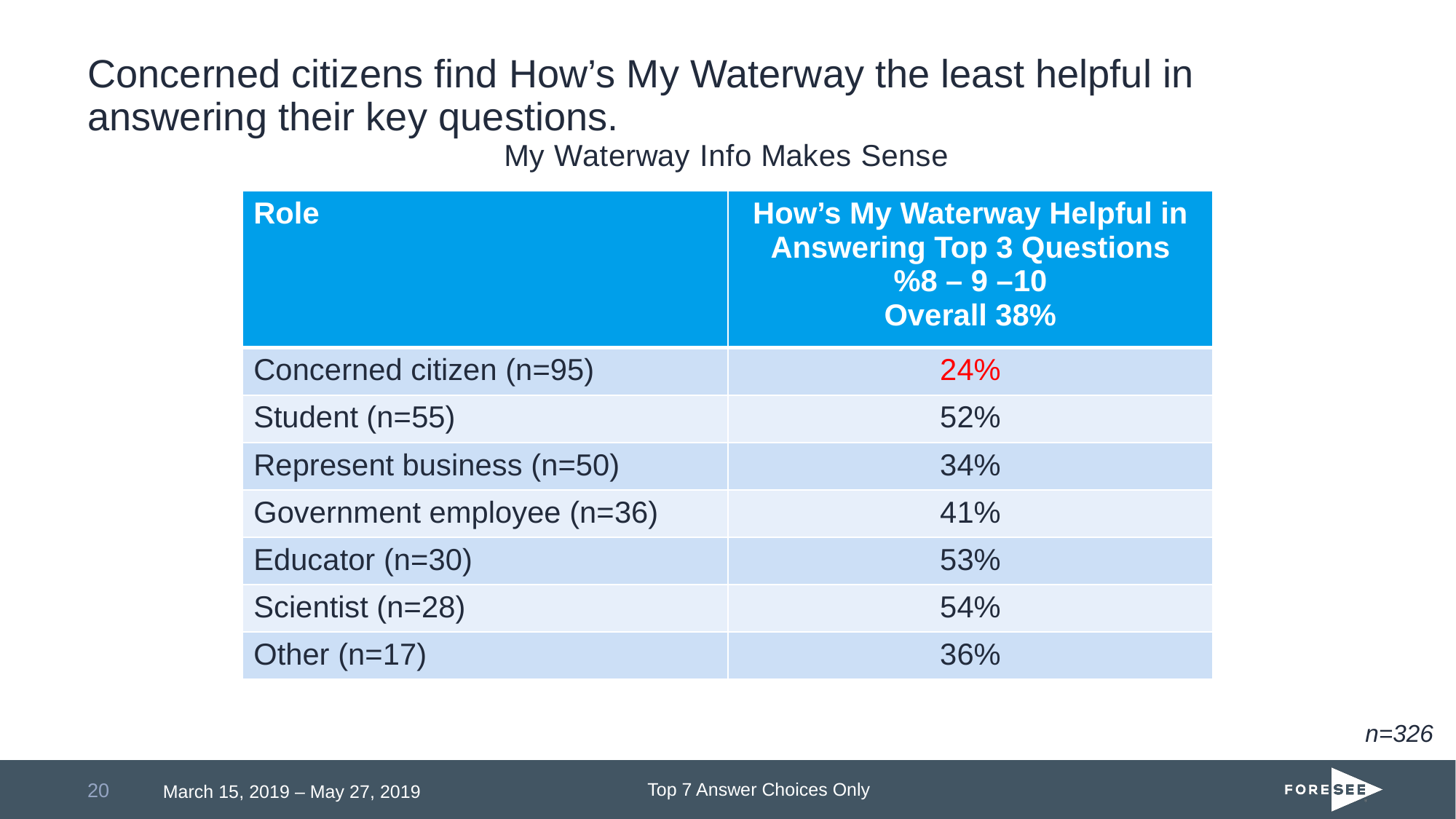
In the My Waterway Info Makes Sense table, what percentage is shown for Other (n=17)? 36% In the My Waterway Info Makes Sense table, what is the difference between the Student and Concerned citizen percentages? 28% In the My Waterway Info Makes Sense table, what is the difference between the Educator and Represent business percentages? 19% What overall percentage is stated in the column header of the My Waterway Info Makes Sense table? 38% How many roles are listed in the My Waterway Info Makes Sense table? 7 In the My Waterway Info Makes Sense table, what percentage is shown for Student (n=55)? 52% In the My Waterway Info Makes Sense table, which role has the lowest percentage? Concerned citizen (n=95) In the My Waterway Info Makes Sense table, what percentage is shown for Concerned citizen (n=95)? 24% In the My Waterway Info Makes Sense table, which is larger, the percentage for Government employee or for Represent business? Government employee In the My Waterway Info Makes Sense table, which value is printed in red? 24% In the My Waterway Info Makes Sense table, what percentage is shown for Government employee (n=36)? 41% In the My Waterway Info Makes Sense table, which role has the highest percentage? Scientist (n=28)